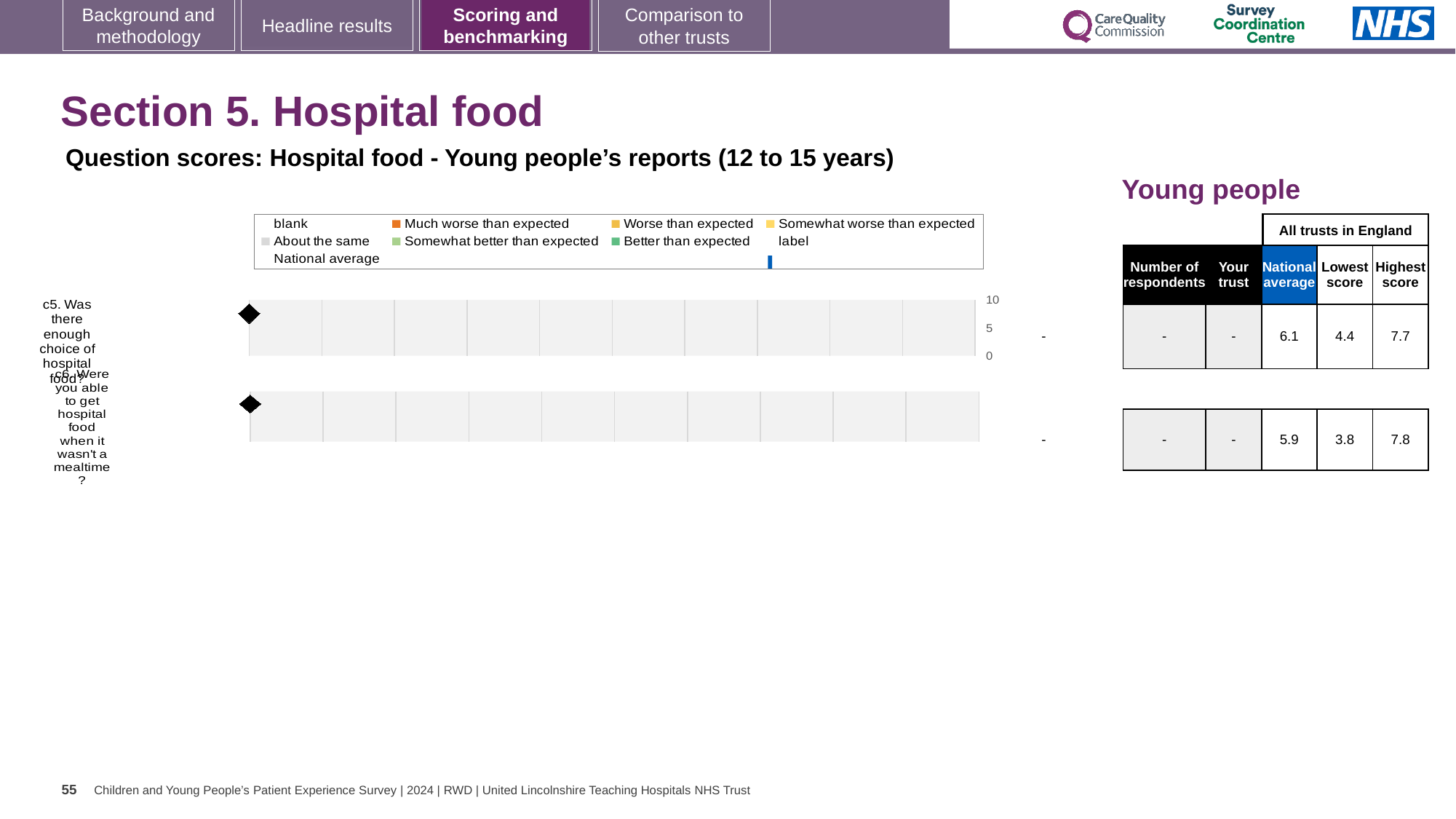
How many survey questions are plotted as rows in the chart? 2 In the table beside the chart, which question has the higher national average, c5 or c6? c5 In the table beside the chart, what is the national average score for c5 (Was there enough choice of hospital food?)? 6.1 In the table beside the chart, what is the difference between the highest and lowest scores for c5? 3.3 In the table beside the chart, what is the national average score for c6 (Were you able to get hospital food when it wasn't a mealtime?)? 5.9 What kind of chart is used to show the question scores? bar chart In the table beside the chart, what is the lowest score across all trusts in England for c5? 4.4 Which legend entry in the chart is shown in orange? Much worse than expected In the table beside the chart, what is the highest score across all trusts in England for c6? 7.8 What is the highest value shown on the chart's numeric axis? 10 In the table beside the chart, what is the difference between the highest and lowest scores for c6? 4.0 In the table beside the chart, what value is shown for 'Your trust' for c5? -